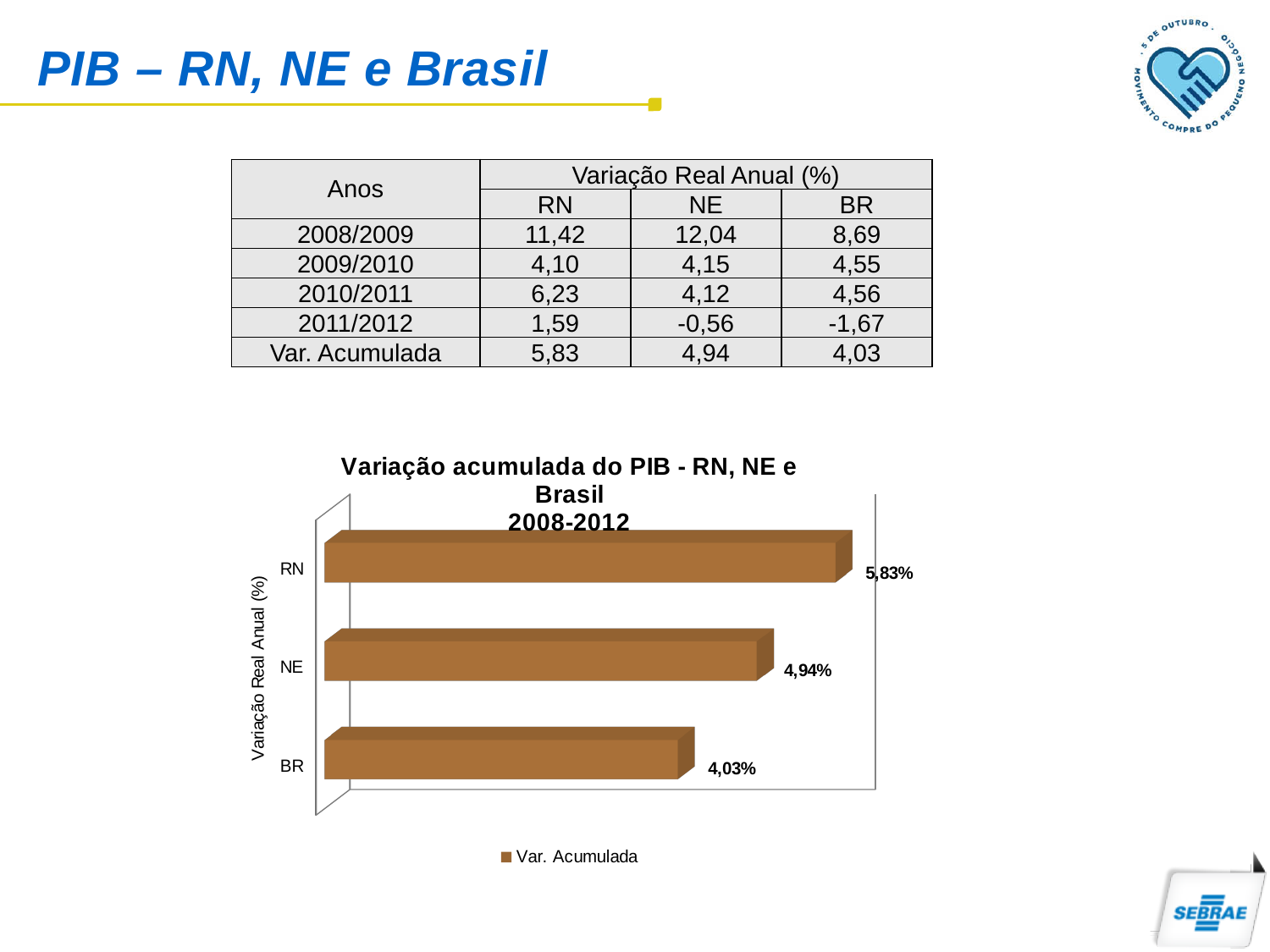
What kind of chart is shown on the slide? Bar chart What is the legend entry of the chart? Var. Acumulada Which category has the lowest value in the chart? BR What is the value for RN in the chart? 5,83% How many series does the chart legend list? 1 What is the difference between the values for RN and BR in the chart? 1,80% What is the difference between the values for RN and NE in the chart? 0,89% Which category has the highest value in the chart? RN Which is larger in the chart, the value for NE or the value for BR? NE What is the value for NE in the chart? 4,94% How many categories are shown in the chart? 3 What is the value for BR in the chart? 4,03%